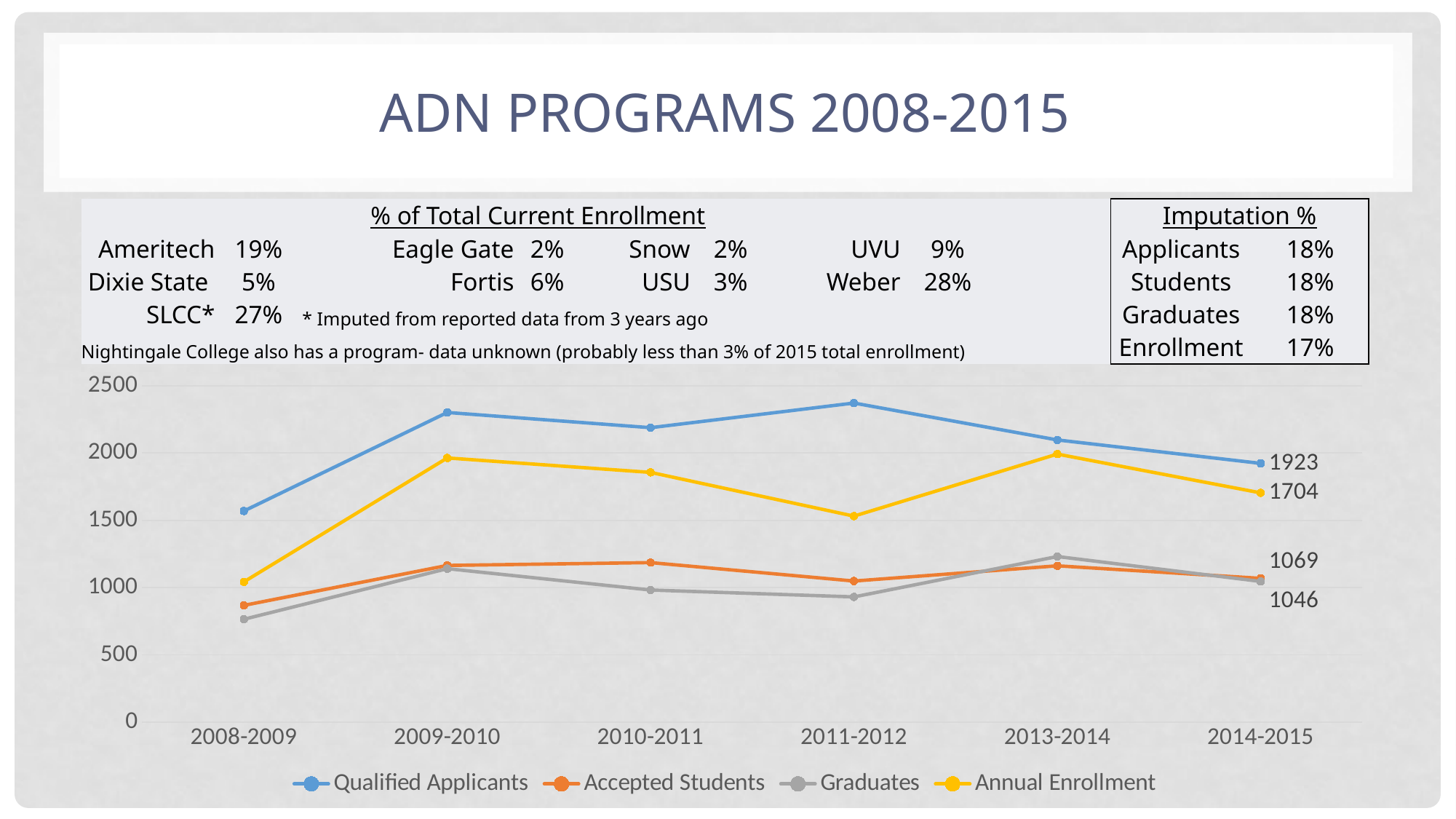
How many series does the chart legend list? 4 What type of chart is shown on the slide? line chart Is the value for Qualified Applicants in 2011-2012 greater or less than 2000? greater What is the value of Qualified Applicants in 2014-2015? 1923 How many academic-year periods are plotted along the x axis? 6 In which period is Qualified Applicants lowest? 2008-2009 What is the value of Annual Enrollment in 2014-2015? 1704 What is the difference between Qualified Applicants and Annual Enrollment in 2014-2015? 219 Does Qualified Applicants rise or fall from 2011-2012 to 2014-2015? fall In which period is Annual Enrollment lowest? 2008-2009 Is the value for Graduates in 2008-2009 greater or less than 1000? less Which is larger in 2009-2010, Annual Enrollment or Accepted Students? Annual Enrollment